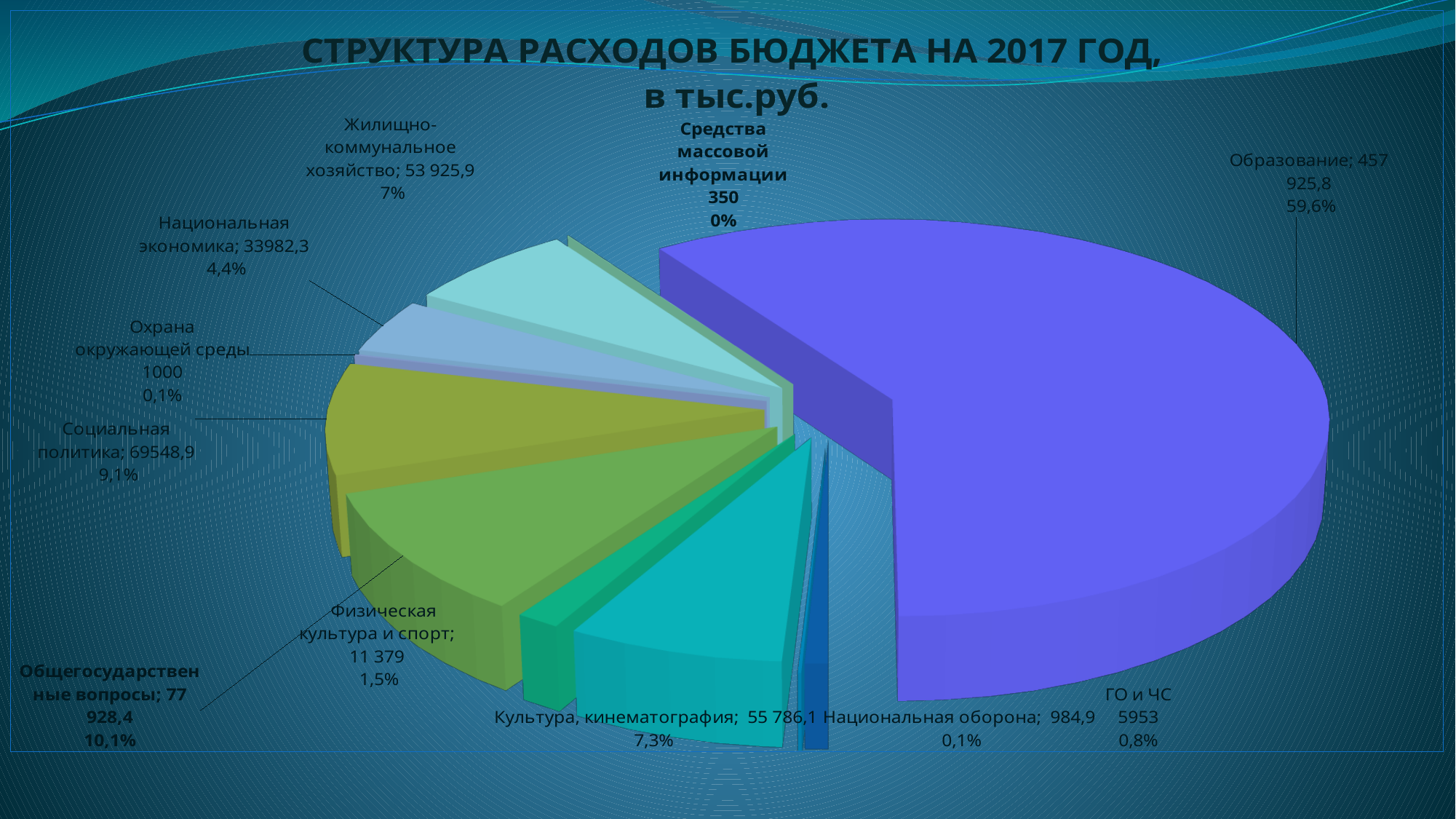
Which category has the smallest value? Средства массовой информации What share of the pie does Образование have? 59,6% What is the title of the chart? СТРУКТУРА РАСХОДОВ БЮДЖЕТА НА 2017 ГОД, в тыс.руб. Which category has the largest share of the pie? Образование What share of the pie does Общегосударственные вопросы have? 10,1% What is the value for Образование? 457 925,8 What is the value for Социальная политика? 69548,9 Which is larger, the value for Культура, кинематография or the value for Жилищно-коммунальное хозяйство? Культура, кинематография What share of the pie does ГО и ЧС have? 0,8% What kind of chart is shown on the slide? pie chart How many categories (slices) does the pie chart have? 11 What is the difference between the value for Охрана окружающей среды and the value for Средства массовой информации? 650